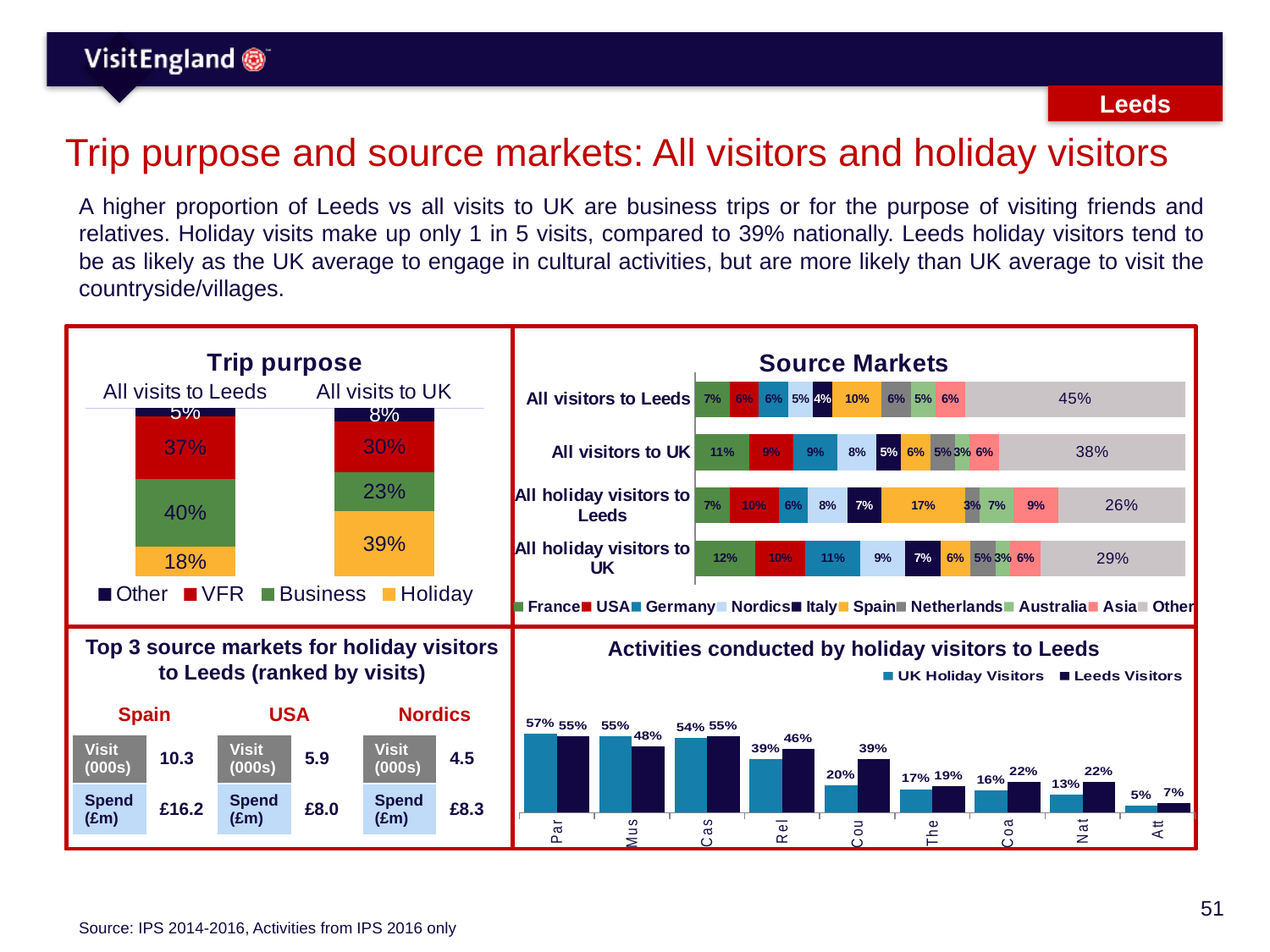
What kind of chart is the Activities conducted by holiday visitors to Leeds chart? Bar chart In the Source Markets chart, what share of all holiday visitors to Leeds falls in the Other category? 26% In the Trip purpose chart, what percentage of all visits to Leeds are Business trips? 40% In the Source Markets chart, what share of all visitors to Leeds comes from Spain? 10% In the Trip purpose chart, what percentage of all visits to the UK are Holiday trips? 39% In the Trip purpose chart, what is the difference between the VFR share for all visits to Leeds and for all visits to the UK? 7 percentage points In the Activities conducted by holiday visitors to Leeds chart, what is the Leeds Visitors value for the category labelled 'Cou'? 39% In the Activities conducted by holiday visitors to Leeds chart, which category has the lowest value for UK Holiday Visitors? Att In the Trip purpose chart, how many series does the legend list? 4 In the Source Markets chart, which bar has the largest Other share? All visitors to Leeds In the Source Markets chart, is the Spain share larger for all holiday visitors to Leeds or for all holiday visitors to the UK? All holiday visitors to Leeds In the Source Markets chart, how many source market series does the legend list? 10